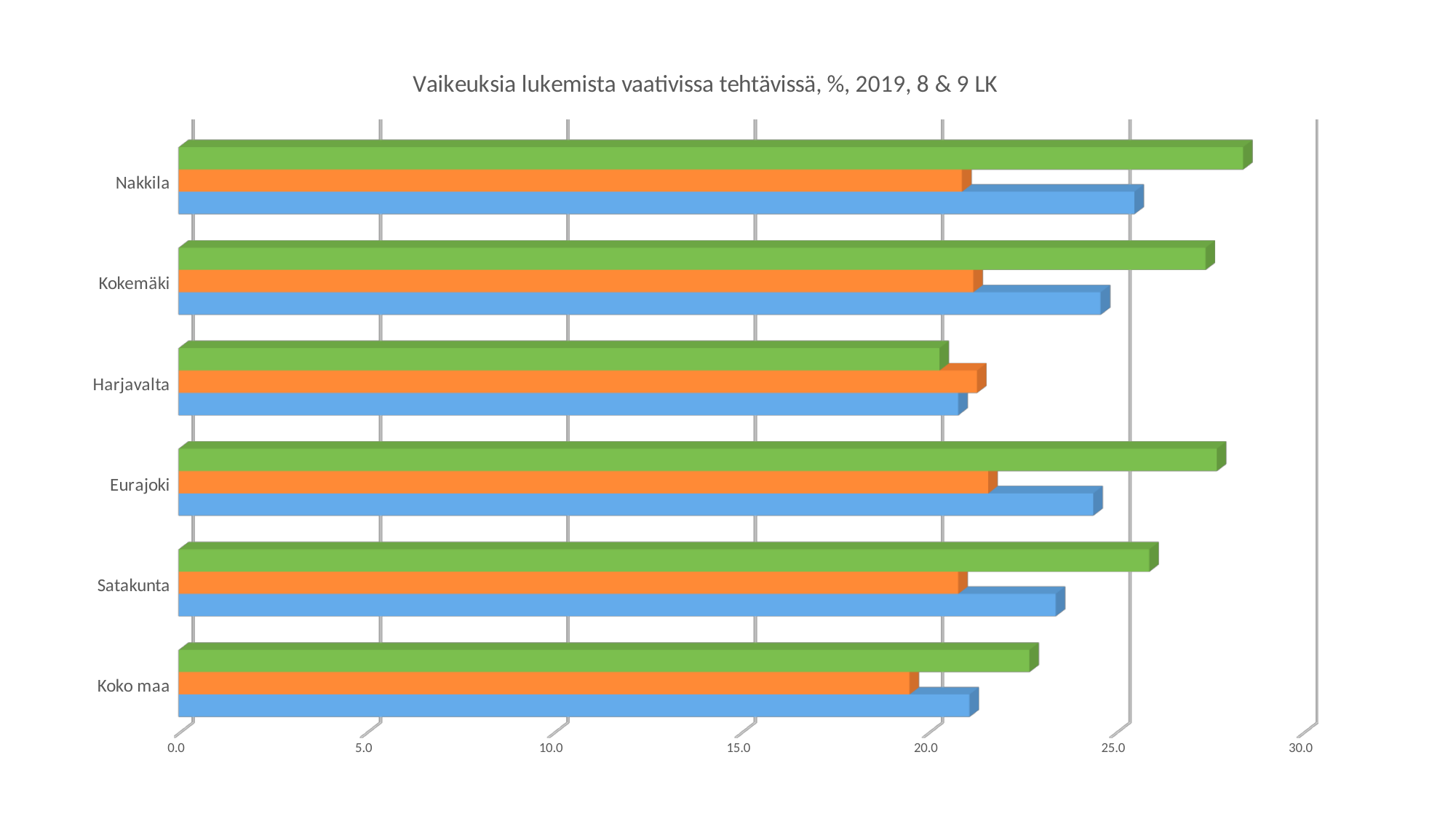
Is the value of the orange bar for Koko maa greater or less than 20.0? less Is the value of the green bar for Eurajoki greater or less than 25.0? greater Which category has the lowest value for the green bar? Harjavalta Which category has the lowest value for the orange bar? Koko maa How many bars are plotted for each category in the chart? 3 Is the value of the green bar for Harjavalta greater or less than 25.0? less How many categories (areas) are shown on the vertical axis of the chart? 6 For Harjavalta, which bar is longer, the orange bar or the green bar? orange What is the title of the chart? Vaikeuksia lukemista vaativissa tehtävissä, %, 2019, 8 & 9 LK What kind of chart is shown on the slide? bar chart